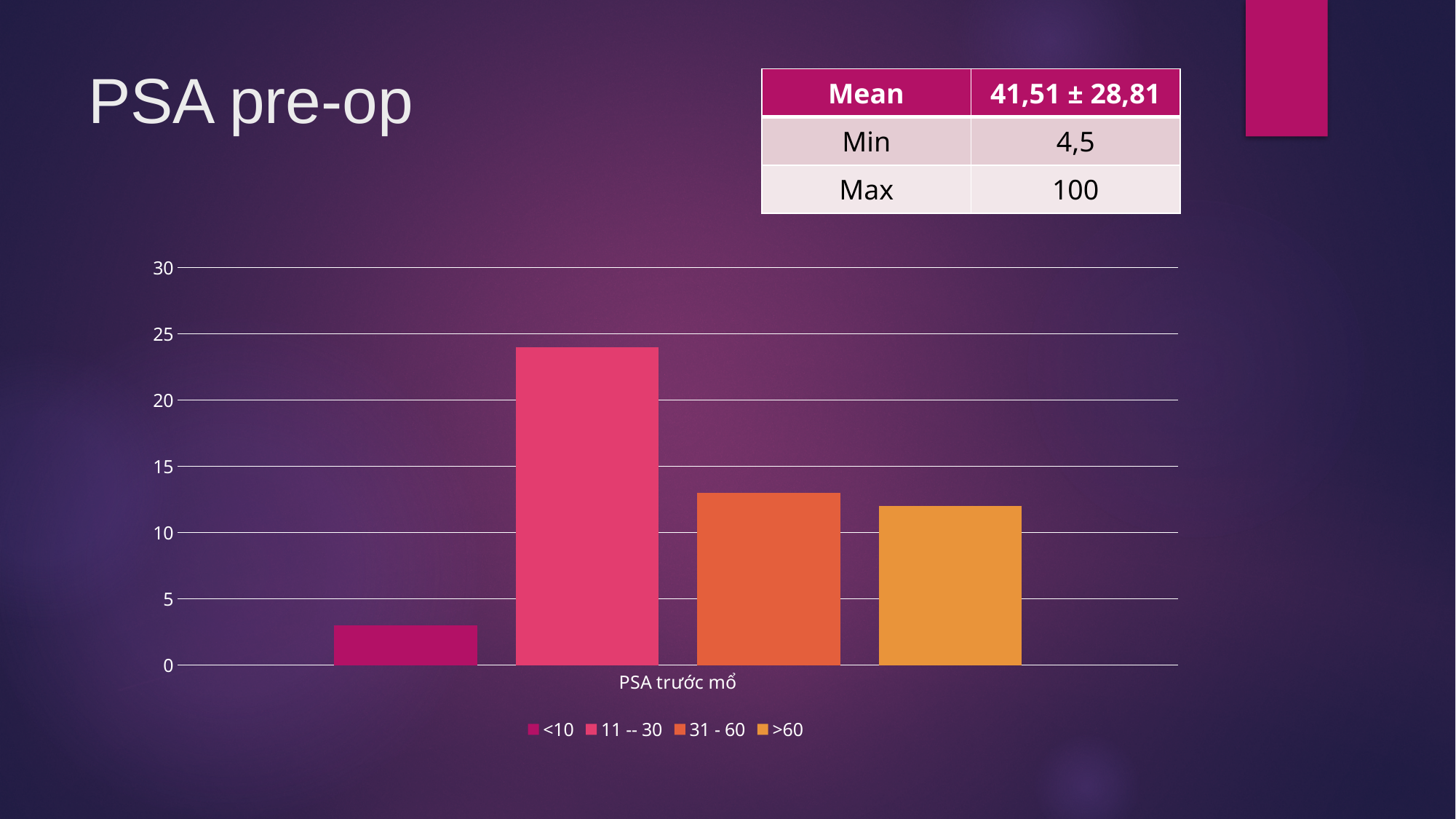
Is the value for the 11 -- 30 series greater or less than 20? greater Is the value for the 31 - 60 series greater or less than 10? greater Which is larger, the value for the 11 -- 30 series or the value for the 31 - 60 series? 11 -- 30 Is the value for the >60 series greater or less than 15? less Which series has the highest bar in the chart? 11 -- 30 Which is larger, the value for the <10 series or the value for the >60 series? >60 What is the category label shown on the x axis of the chart? PSA trước mổ What kind of chart is shown on the slide? bar chart Which series has the lowest bar in the chart? <10 How many series does the chart legend list? 4 What is the title of the slide containing the chart? PSA pre-op